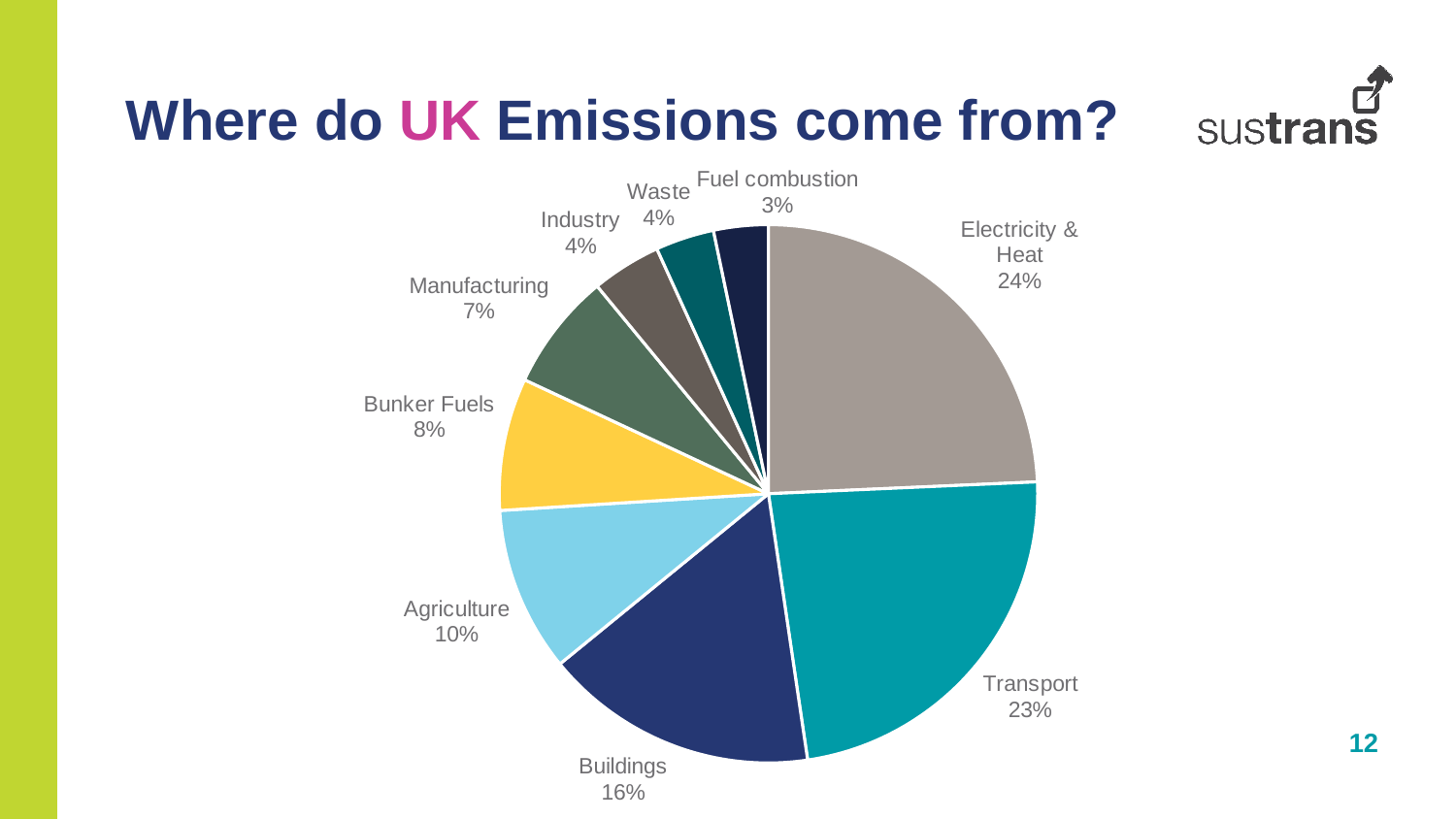
What is the title of the slide containing the pie chart? Where do UK Emissions come from? What is the value shown for Bunker Fuels? 8% How many categories are shown in the pie chart? 9 What is the difference in percentage points between Electricity & Heat and Transport? 1 Which category has the largest share of UK emissions? Electricity & Heat Which category has the smallest share of UK emissions? Fuel combustion What is the value shown for Buildings? 16% What is the difference in percentage points between Buildings and Agriculture? 6 What kind of chart is shown on the slide? Pie chart Which has a larger share, Agriculture or Manufacturing? Agriculture What share of UK emissions comes from Transport? 23% What share of UK emissions comes from Electricity & Heat? 24%